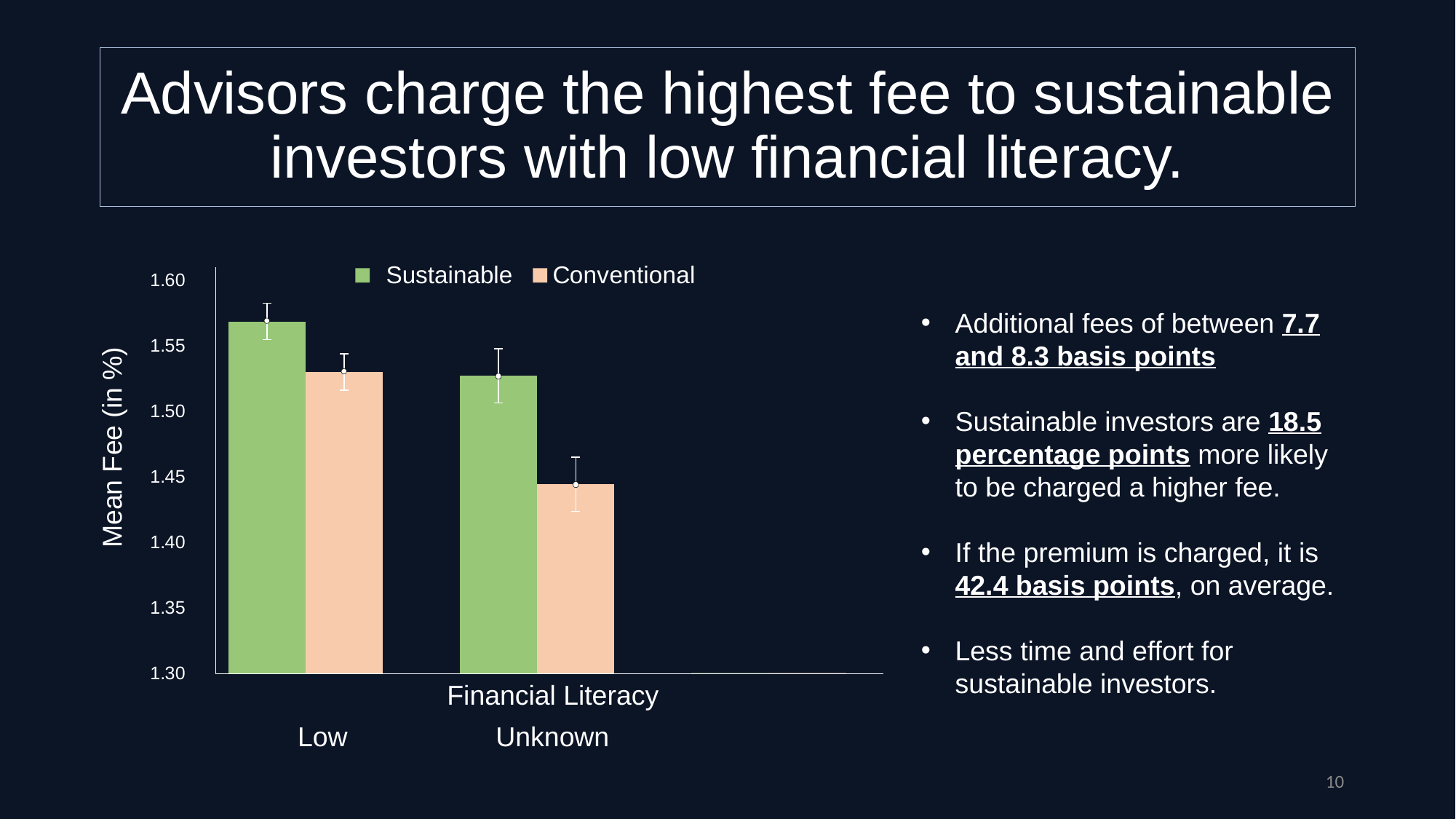
Does the mean fee for Conventional investors rise or fall from the Low to the Unknown financial literacy category? fall For the Low financial literacy category, which series has the higher mean fee, Sustainable or Conventional? Sustainable Which bar in the chart is the lowest? Conventional, Unknown For the Unknown financial literacy category, which series has the higher mean fee, Sustainable or Conventional? Sustainable What kind of chart is shown on the slide? Bar chart Is the mean fee for Conventional investors with Unknown financial literacy greater or less than 1.50? less What is the label of the vertical axis of the chart? Mean Fee (in %) Which bar in the chart is the highest? Sustainable, Low How many financial literacy categories are shown on the x axis of the chart? 2 How many series does the chart legend list? 2 Is the mean fee for Sustainable investors with Low financial literacy greater or less than 1.55? greater Is the mean fee for Sustainable investors with Unknown financial literacy greater or less than 1.50? greater